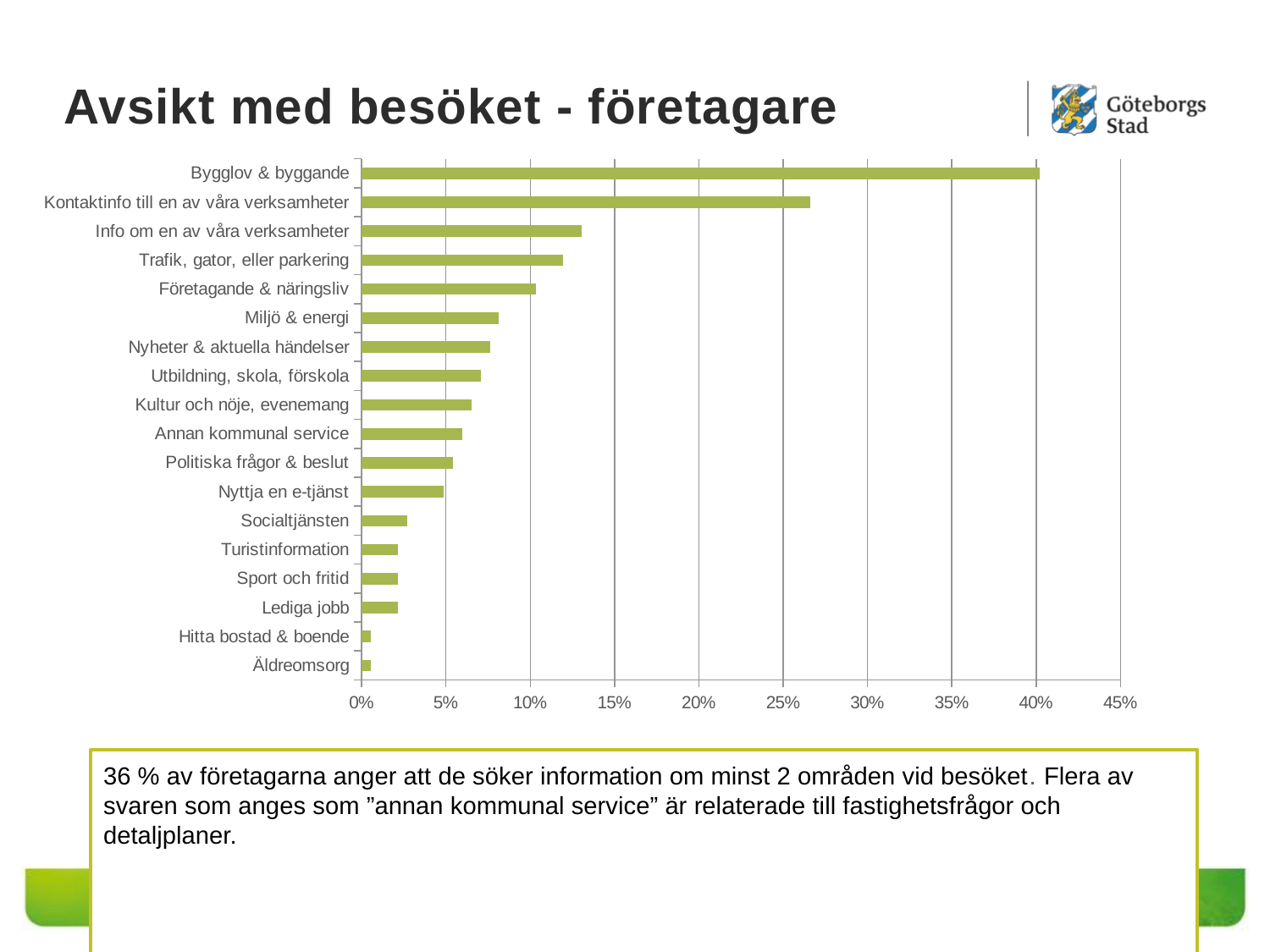
How many categories are shown in the chart? 18 Is the value for Info om en av våra verksamheter greater or less than 10%? greater What is the title of the chart? Avsikt med besöket - företagare Is the value for Kontaktinfo till en av våra verksamheter greater or less than 25%? greater Which category has the highest value? Bygglov & byggande Which is larger, the value for Bygglov & byggande or the value for Kontaktinfo till en av våra verksamheter? Bygglov & byggande Is the value for Bygglov & byggande greater or less than 35%? greater What kind of chart is shown on the slide? bar chart Which is larger, the value for Nyheter & aktuella händelser or the value for Socialtjänsten? Nyheter & aktuella händelser What is the highest value shown on the horizontal axis? 45%